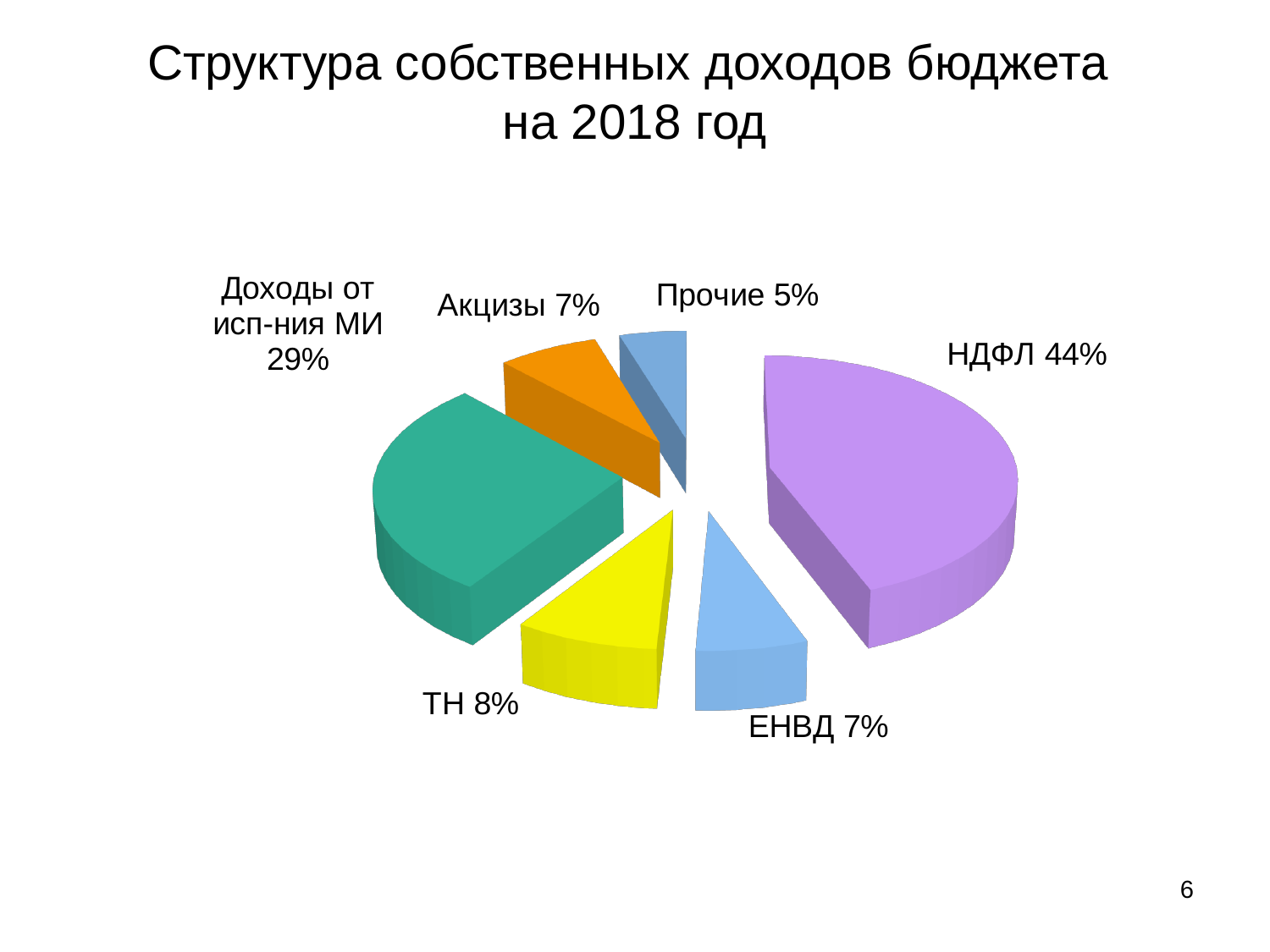
Which category has the smallest share of the pie? Прочие What kind of chart is shown on the slide? Pie chart What share of the budget's own revenues does НДФЛ account for? 44% What is the value shown for Прочие? 5% What is the title of the chart on the slide? Структура собственных доходов бюджета на 2018 год What is the value shown for Акцизы? 7% Which category has the largest share of the pie? НДФЛ What is the difference between the shares of НДФЛ and Доходы от исп-ния МИ? 15% Which is larger, the share for ТН or the share for ЕНВД? ТН How many slices does the pie chart have? 6 What share is shown for Доходы от исп-ния МИ? 29% What is the value shown for ТН? 8%